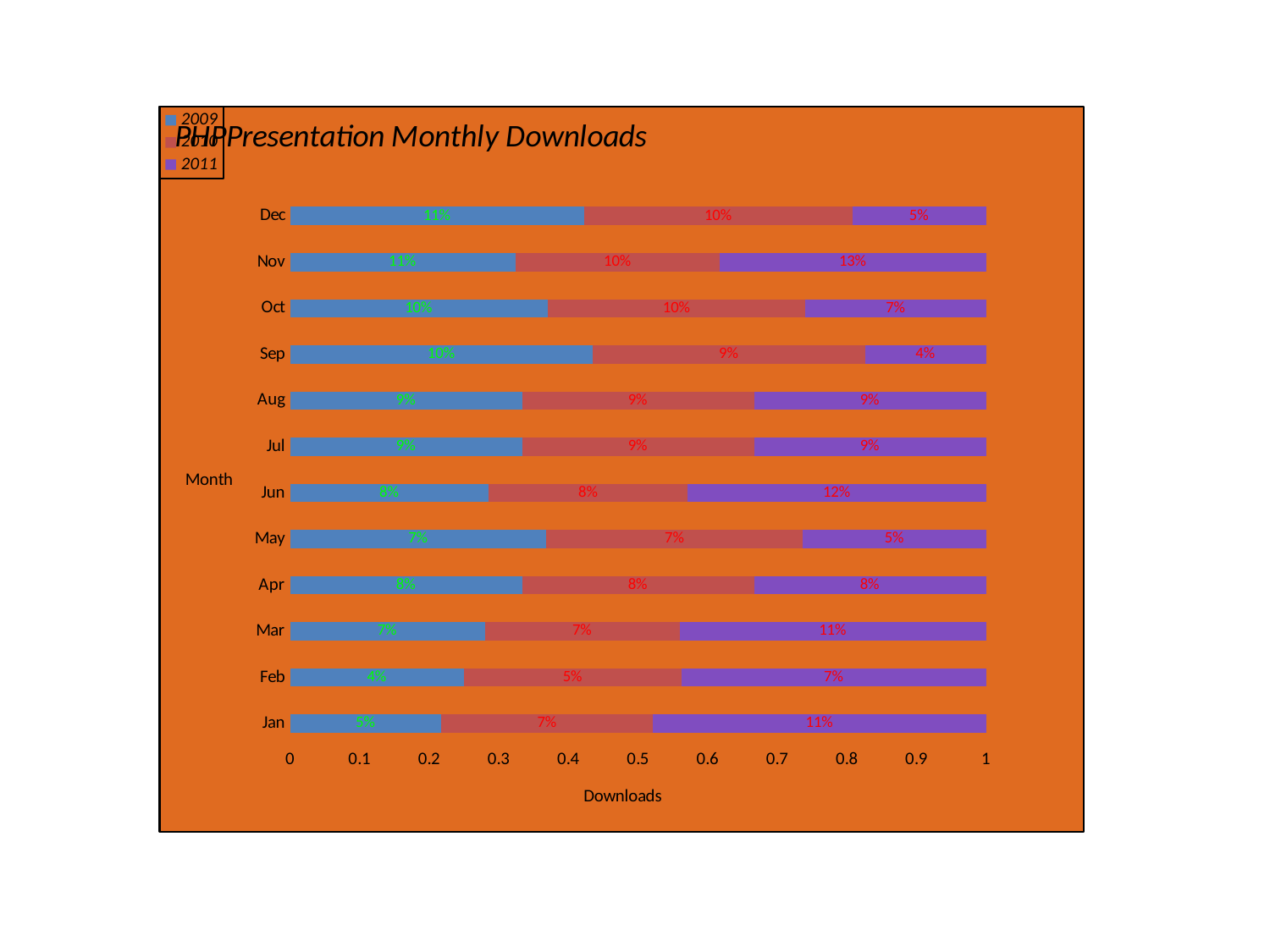
Which month has the lowest 2009 value? Feb What is the difference between the 2011 value for Jun and the 2011 value for May? 7% Which is larger, the 2011 value for Mar or the 2011 value for Dec? Mar What is the 2011 value for Nov? 13% What is the 2011 value for Sep? 4% What is the 2009 value for Feb? 4% How many series does the legend list? 3 What is the title of the chart? PHPPresentation Monthly Downloads Which month has the highest 2011 value? Nov What is the 2010 value for Jan? 7% How many months are shown on the chart? 12 What kind of chart is shown on the slide? Stacked bar chart